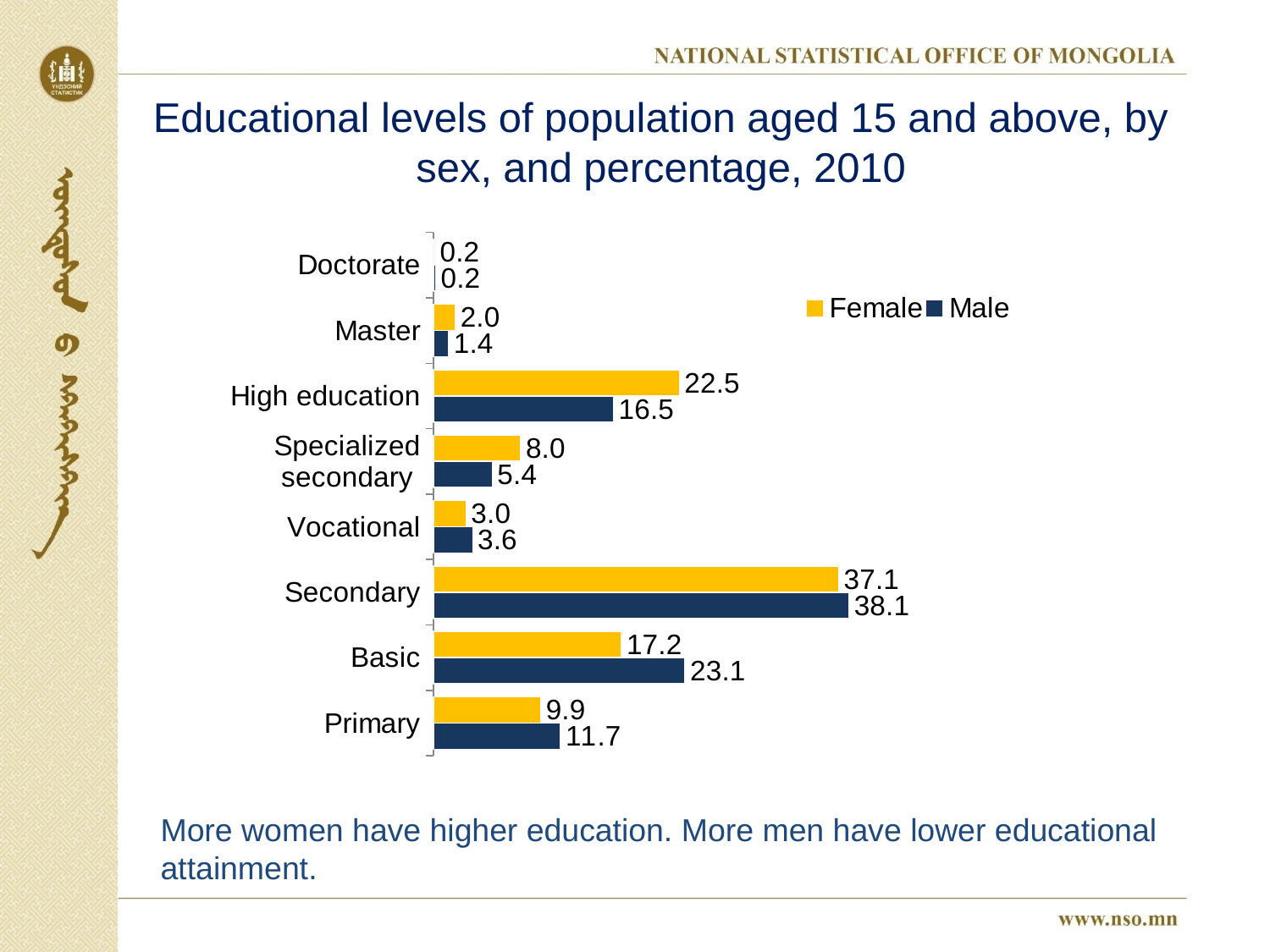
Which is larger for Secondary, the Female value or the Male value? Male How many series does the legend list? 2 What is the Male value for Basic? 23.1 What is the difference between the Female and Male values for High education? 6.0 Which category has the lowest Female value? Doctorate How many educational level categories are shown in the chart? 8 What is the difference between the Male and Female values for Basic? 5.9 What kind of chart is shown on the slide? Bar chart Which category has the highest Male value? Secondary Which is larger for Master, the Female value or the Male value? Female What is the Female value for High education? 22.5 What is the Female value for Vocational? 3.0